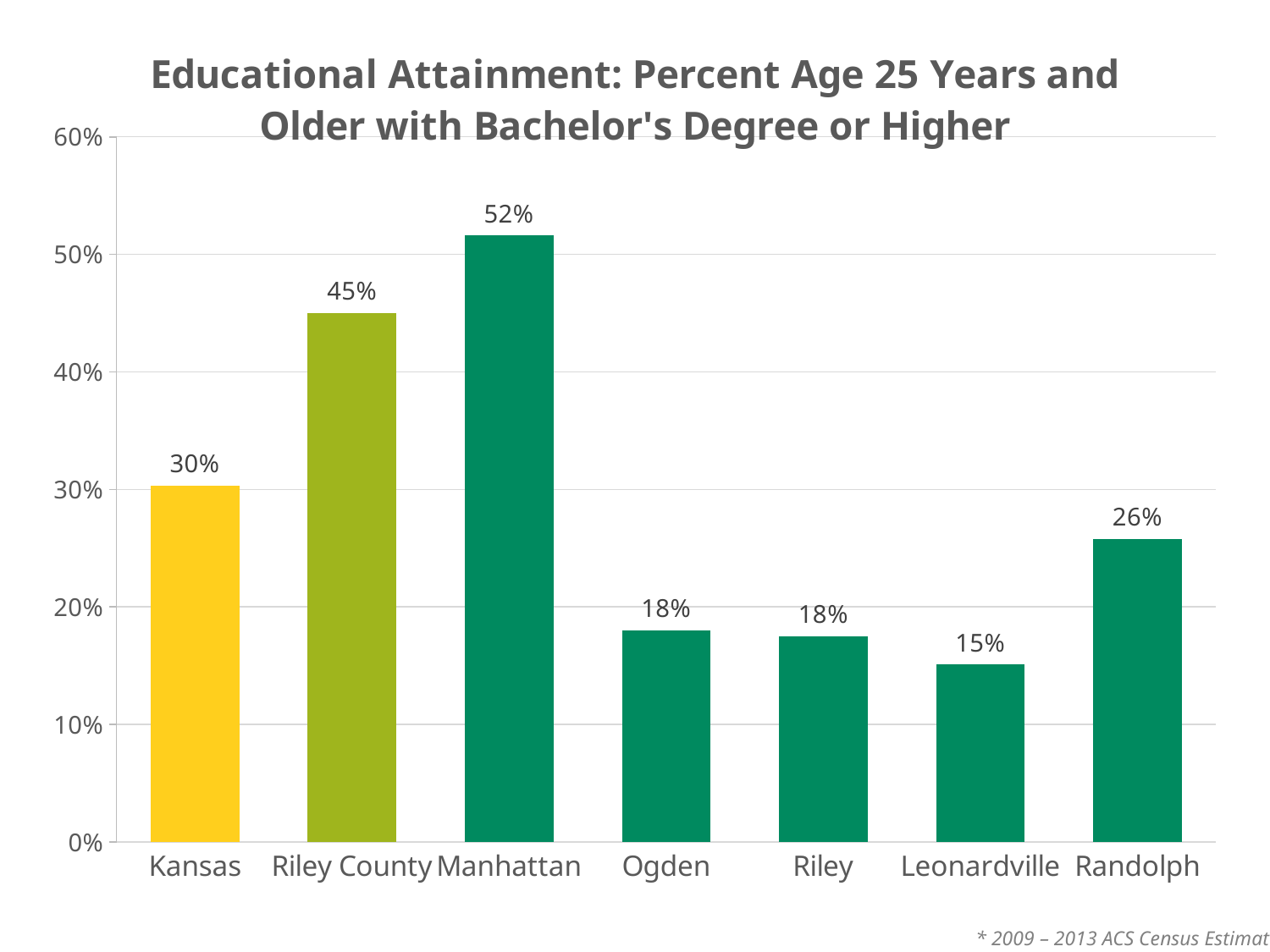
What is the value for Manhattan? 52% Which category has the highest value? Manhattan What is the difference between the values for Manhattan and Riley County? 7% Which is larger, the value for Kansas or the value for Randolph? Kansas Is the value for Riley County greater or less than 40%? greater How many categories are shown on the x axis? 7 What kind of chart is shown on the slide? bar chart What is the value for Leonardville? 15% What is the value for Randolph? 26% Which category has the lowest value? Leonardville What is the value for Kansas? 30% What colour is the bar for Kansas? yellow